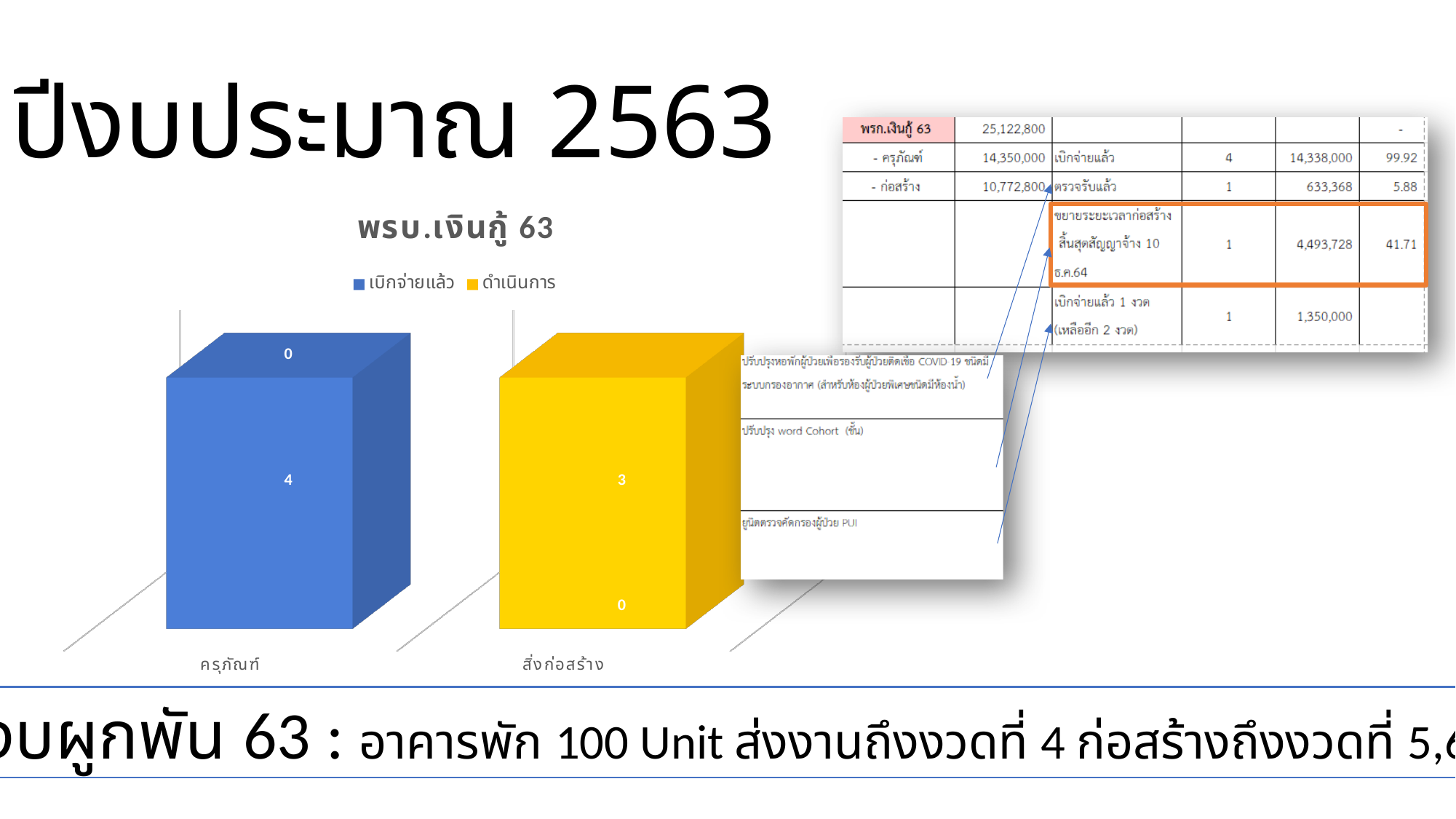
What is the value of เบิกจ่ายแล้ว for สิ่งก่อสร้าง? 0 What is the title of the chart? พรบ.เงินกู้ 63 What is the total of the stacked bar for ครุภัณฑ์? 4 What is the value of เบิกจ่ายแล้ว for ครุภัณฑ์? 4 What is the total of the stacked bar for สิ่งก่อสร้าง? 3 What is the difference between the เบิกจ่ายแล้ว value for ครุภัณฑ์ and the ดำเนินการ value for สิ่งก่อสร้าง? 1 What kind of chart is shown on the slide? bar chart How many series does the chart legend list? 2 Which is larger: เบิกจ่ายแล้ว for ครุภัณฑ์ or ดำเนินการ for สิ่งก่อสร้าง? เบิกจ่ายแล้ว for ครุภัณฑ์ What is the value of ดำเนินการ for ครุภัณฑ์? 0 What is the value of ดำเนินการ for สิ่งก่อสร้าง? 3 How many categories are shown on the x axis of the chart? 2